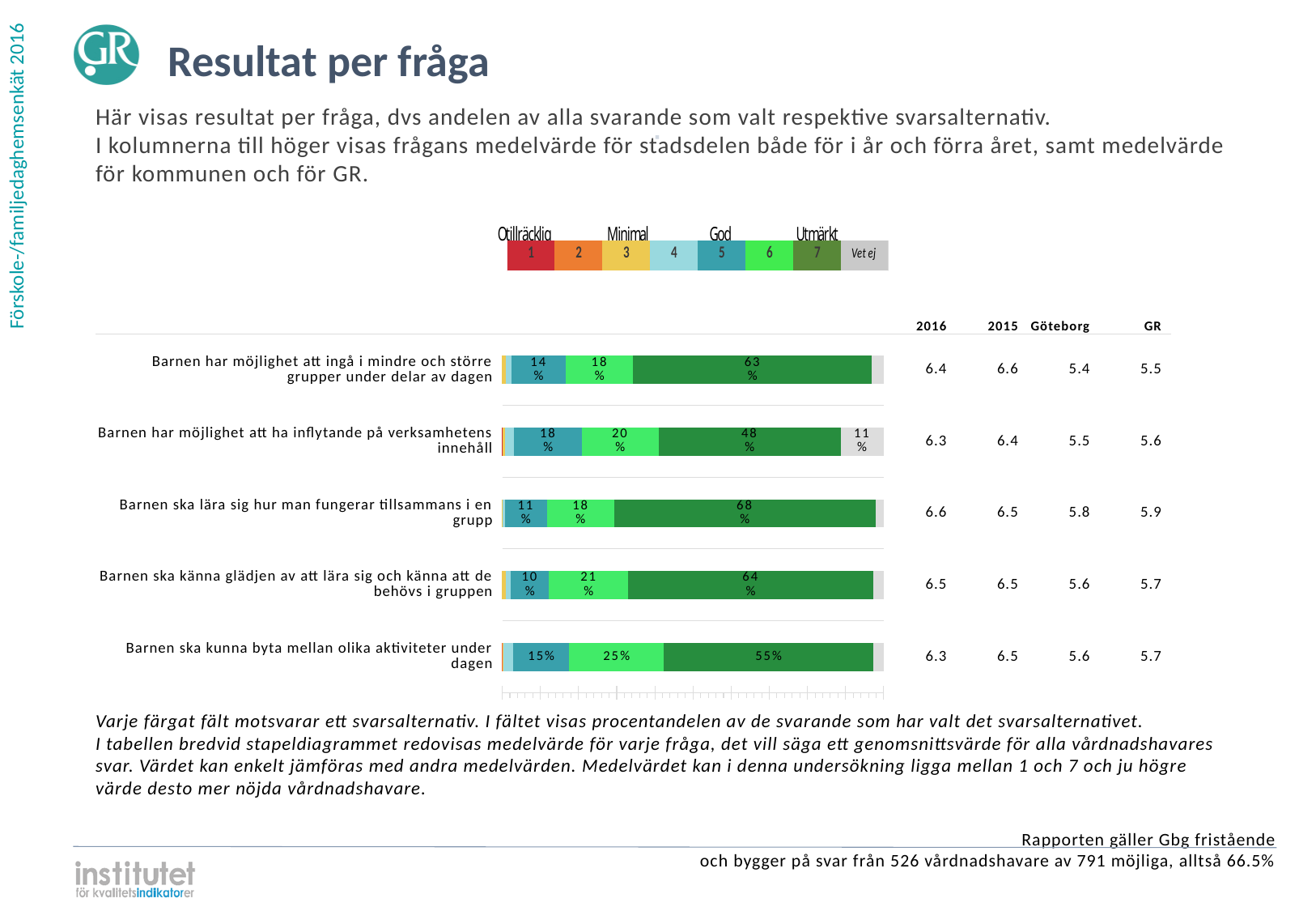
What is the GR mean value for "Barnen har möjlighet att ingå i mindre och större grupper under delar av dagen"? 5.5 Which question has the highest share of respondents choosing option 7? Barnen ska lära sig hur man fungerar tillsammans i en grupp What is the difference between the option 7 share for "Barnen ska lära sig hur man fungerar tillsammans i en grupp" (68%) and for "Barnen ska kunna byta mellan olika aktiviteter under dagen" (55%)? 13% Is the option 6 share larger for "Barnen ska kunna byta mellan olika aktiviteter under dagen" or for "Barnen har möjlighet att ingå i mindre och större grupper under delar av dagen"? Barnen ska kunna byta mellan olika aktiviteter under dagen What percentage of respondents chose option 5 for "Barnen ska känna glädjen av att lära sig och känna att de behövs i gruppen"? 10% What percentage of respondents answered "Vet ej" for "Barnen har möjlighet att ha inflytande på verksamhetens innehåll"? 11% What percentage of respondents chose option 7 for "Barnen ska lära sig hur man fungerar tillsammans i en grupp"? 68% Which question has the lowest share of respondents choosing option 7? Barnen har möjlighet att ha inflytande på verksamhetens innehåll How many questions (categories) are shown in the bar chart? 5 What percentage of respondents chose option 6 for "Barnen ska kunna byta mellan olika aktiviteter under dagen"? 25% What is the 2016 mean value for "Barnen ska lära sig hur man fungerar tillsammans i en grupp"? 6.6 What kind of chart is used to show the results per question? stacked bar chart